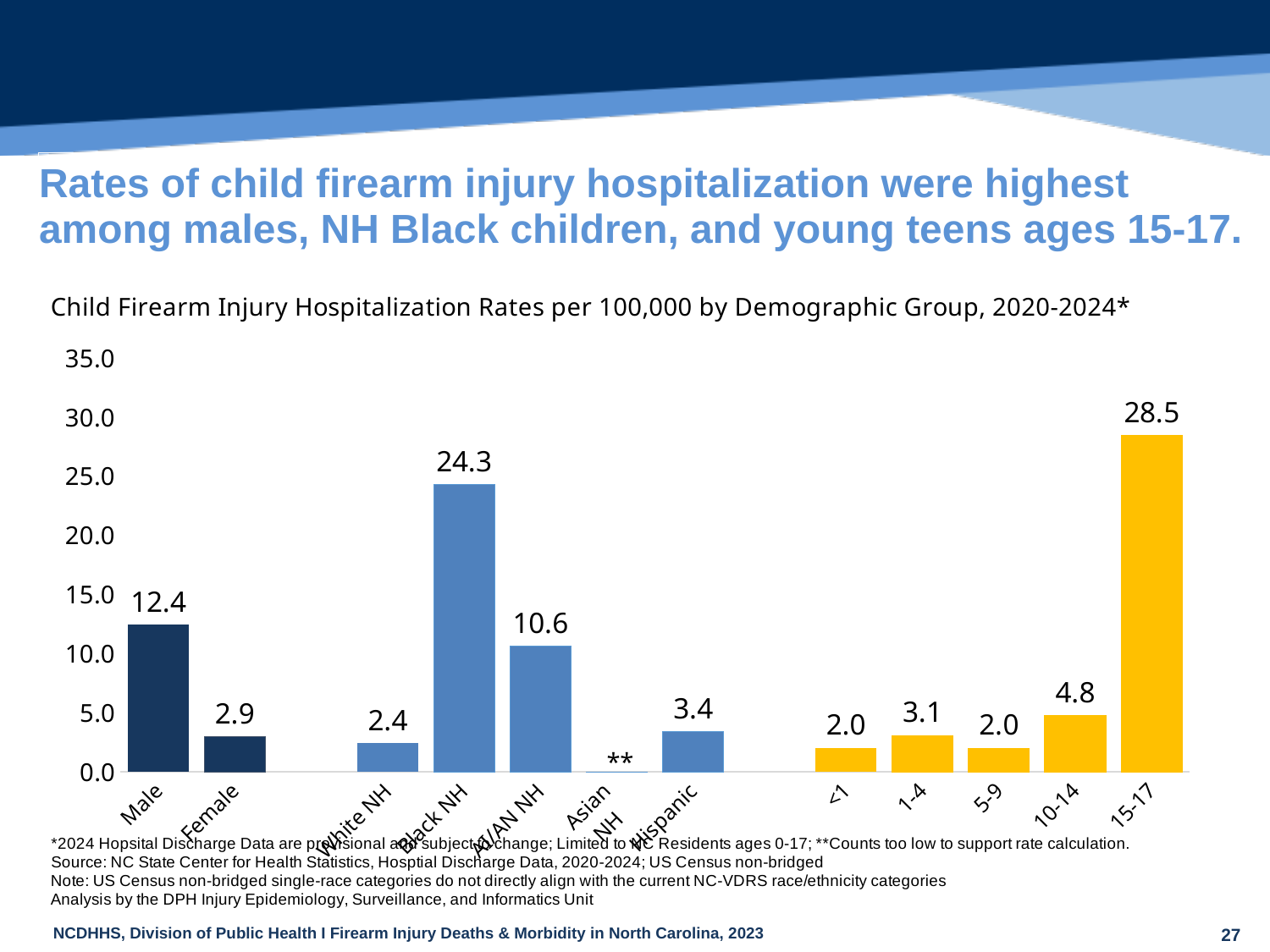
What is the difference between the hospitalization rates for ages 15-17 and ages 10-14? 23.7 How many demographic groups are labeled along the x axis of the chart? 12 Which has a higher hospitalization rate, AI/AN NH or Hispanic children? AI/AN NH What is the child firearm injury hospitalization rate per 100,000 for males? 12.4 What is shown in place of a value for the Asian NH bar? ** What type of chart is shown on the slide? bar chart What is the hospitalization rate for Black NH children? 24.3 Among the race/ethnicity groups with a rate shown, which has the lowest hospitalization rate? White NH What is the difference between the male and female hospitalization rates? 9.5 What is the hospitalization rate for children ages 10-14? 4.8 Which demographic group has the highest hospitalization rate on the chart? 15-17 Is the hospitalization rate for Black NH children greater or less than 20.0? greater